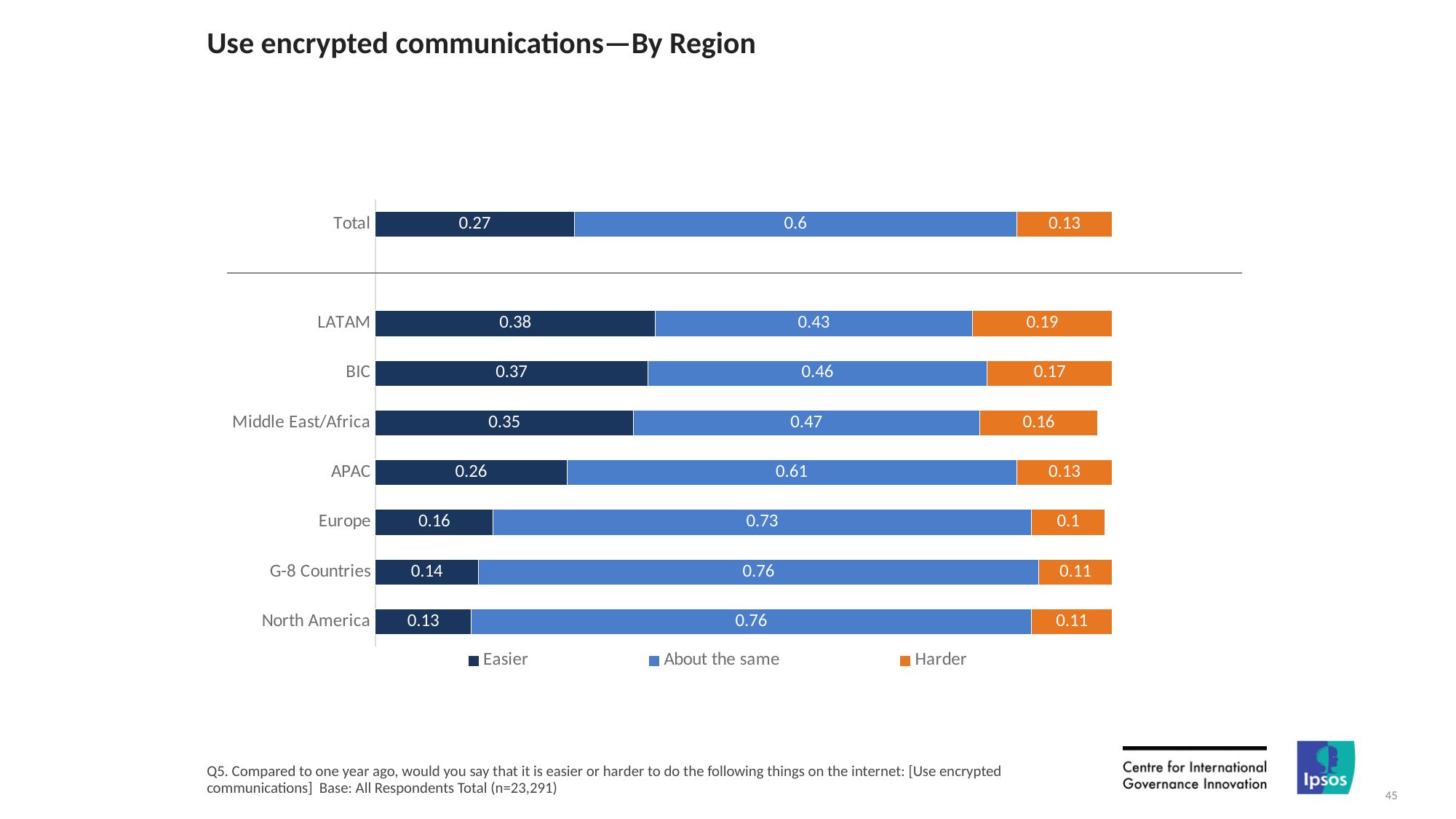
What is the 'About the same' value for Europe? 0.73 What kind of chart is shown on the slide? Stacked bar chart How many series does the legend list? 3 Which region has the lowest 'About the same' value? LATAM What is the 'Harder' value for Middle East/Africa? 0.16 What is the 'Easier' value for LATAM? 0.38 Which is larger, the 'About the same' value for APAC or for BIC? APAC How many regions (including Total) are shown on the chart? 8 Which region has the highest 'Harder' value? LATAM Which region has the lowest 'Easier' value? North America What is the difference between the 'Easier' values for LATAM and Europe? 0.22 What is the title of the chart? Use encrypted communications—By Region